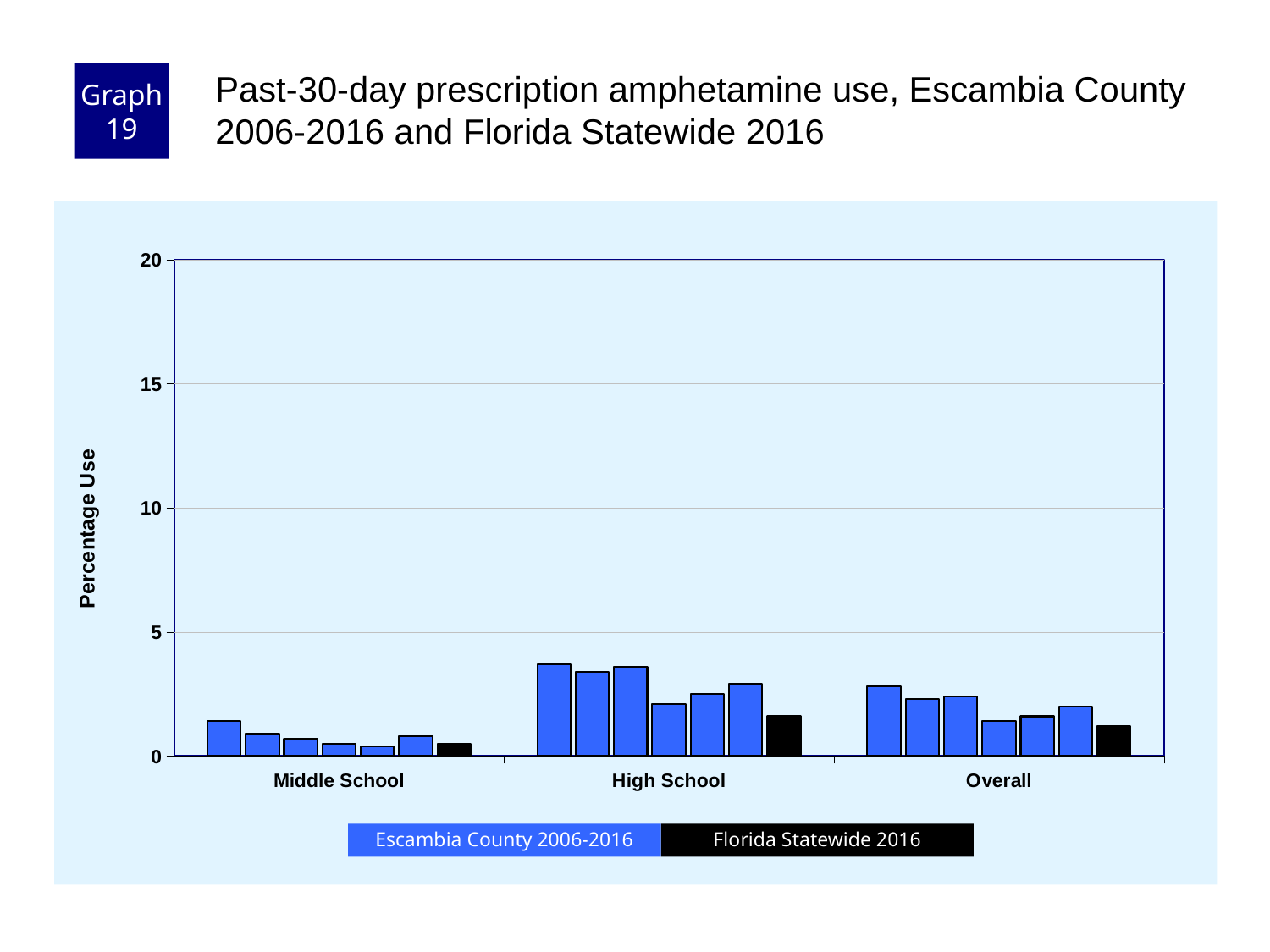
Which is larger, the first Escambia County bar in the High School group or the first Escambia County bar in the Middle School group? High School What is the label on the y axis? Percentage Use How many series does the legend list? 2 Is the value for Florida Statewide 2016 in the High School group greater or less than 5? less Which group has the lowest bars overall: Middle School, High School, or Overall? Middle School What colour represents Florida Statewide 2016 in the legend? black Is the tallest Escambia County bar in the High School group greater or less than 5? less Which is larger, the Florida Statewide 2016 value for High School or the Florida Statewide 2016 value for Middle School? High School Is the Florida Statewide 2016 value for Middle School greater or less than 5? less How many school-level categories are shown on the x axis? 3 What kind of chart is shown on the slide? bar chart Which group has the highest bars overall: Middle School, High School, or Overall? High School